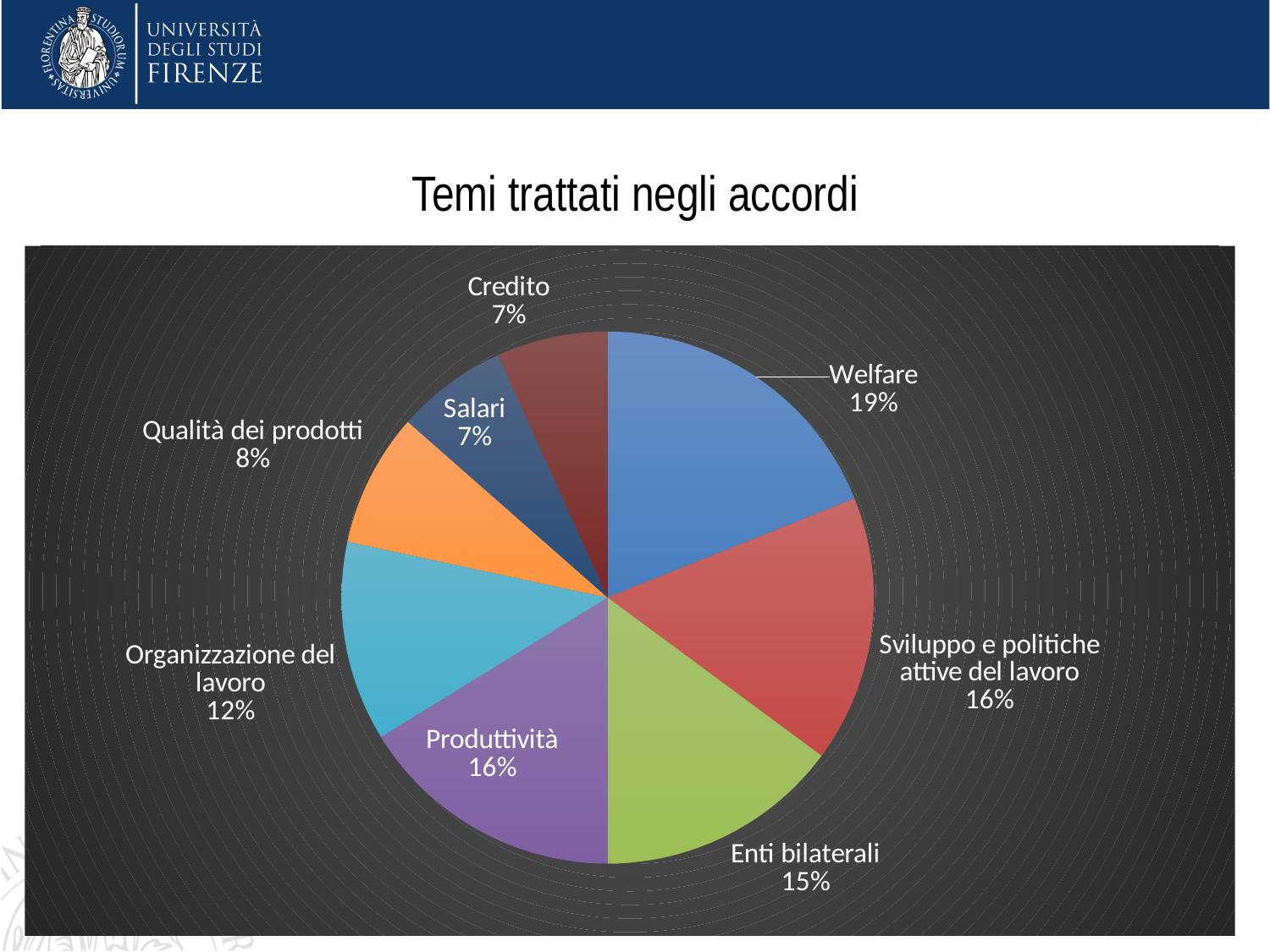
What is the title of the chart? Temi trattati negli accordi What kind of chart is shown on the slide? pie chart What is the value shown for Qualità dei prodotti? 8% Which is larger, the share for Welfare or the share for Enti bilaterali? Welfare What share of the pie does Welfare represent? 19% How many slices does the pie chart have? 8 What is the value shown for Salari? 7% Which category has the largest slice of the pie? Welfare What is the value shown for Enti bilaterali? 15% What is the difference in percentage points between Welfare and Organizzazione del lavoro? 7 What is the value shown for Organizzazione del lavoro? 12% What is the value shown for Sviluppo e politiche attive del lavoro? 16%